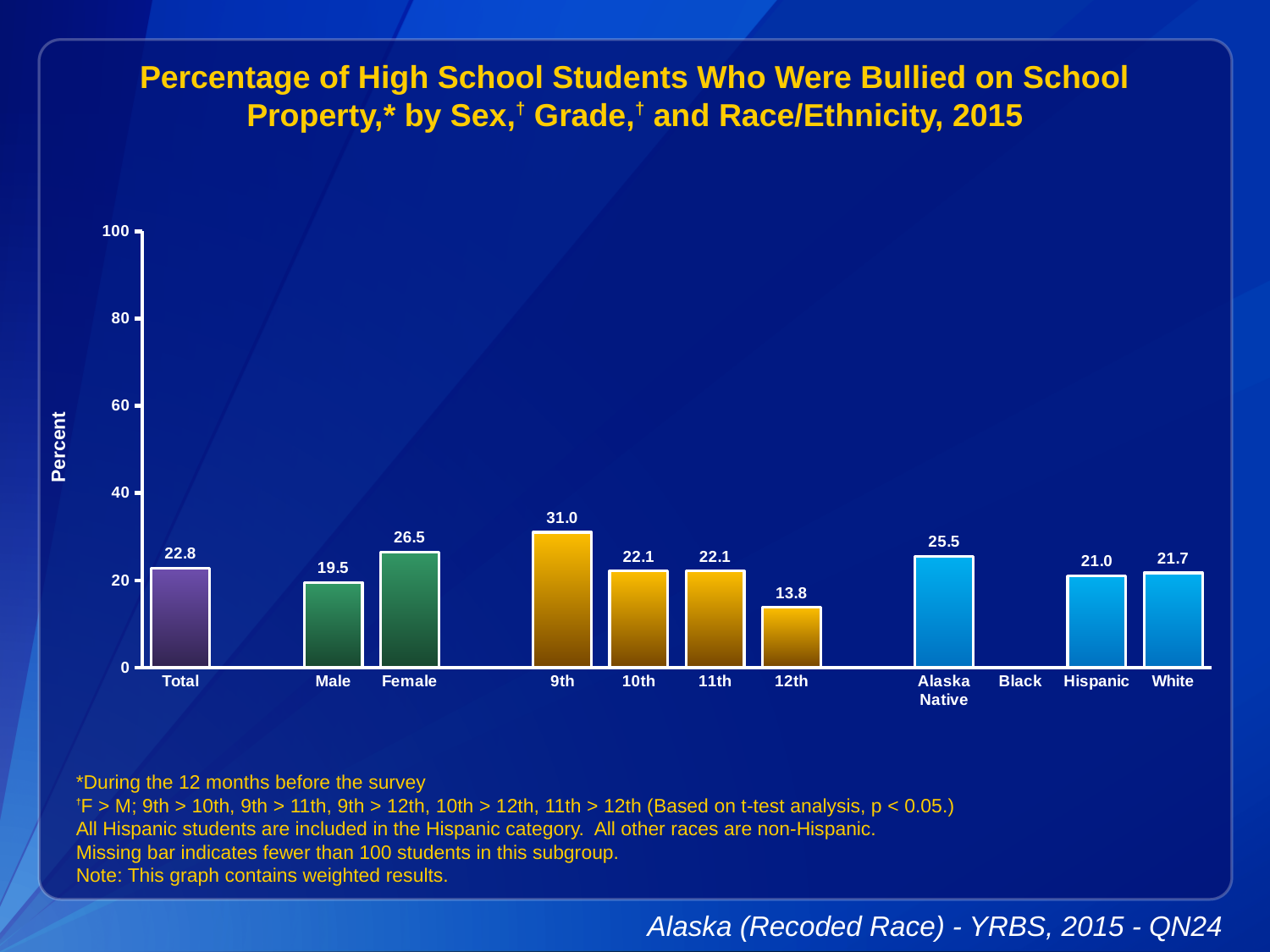
What is the value for Total? 22.8 How many bars are plotted on the chart? 10 What kind of chart is shown? bar chart Which is larger, the value for Hispanic or the value for White? White What is the value for Alaska Native? 25.5 What is the difference between the Female and Male values? 7.0 Is the value for 9th grade greater or less than 40? less What is the value for Female? 26.5 Which race/ethnicity category has no bar shown? Black What is the value for 12th grade? 13.8 Which category has the highest value? 9th Which category has the lowest value among the bars shown? 12th